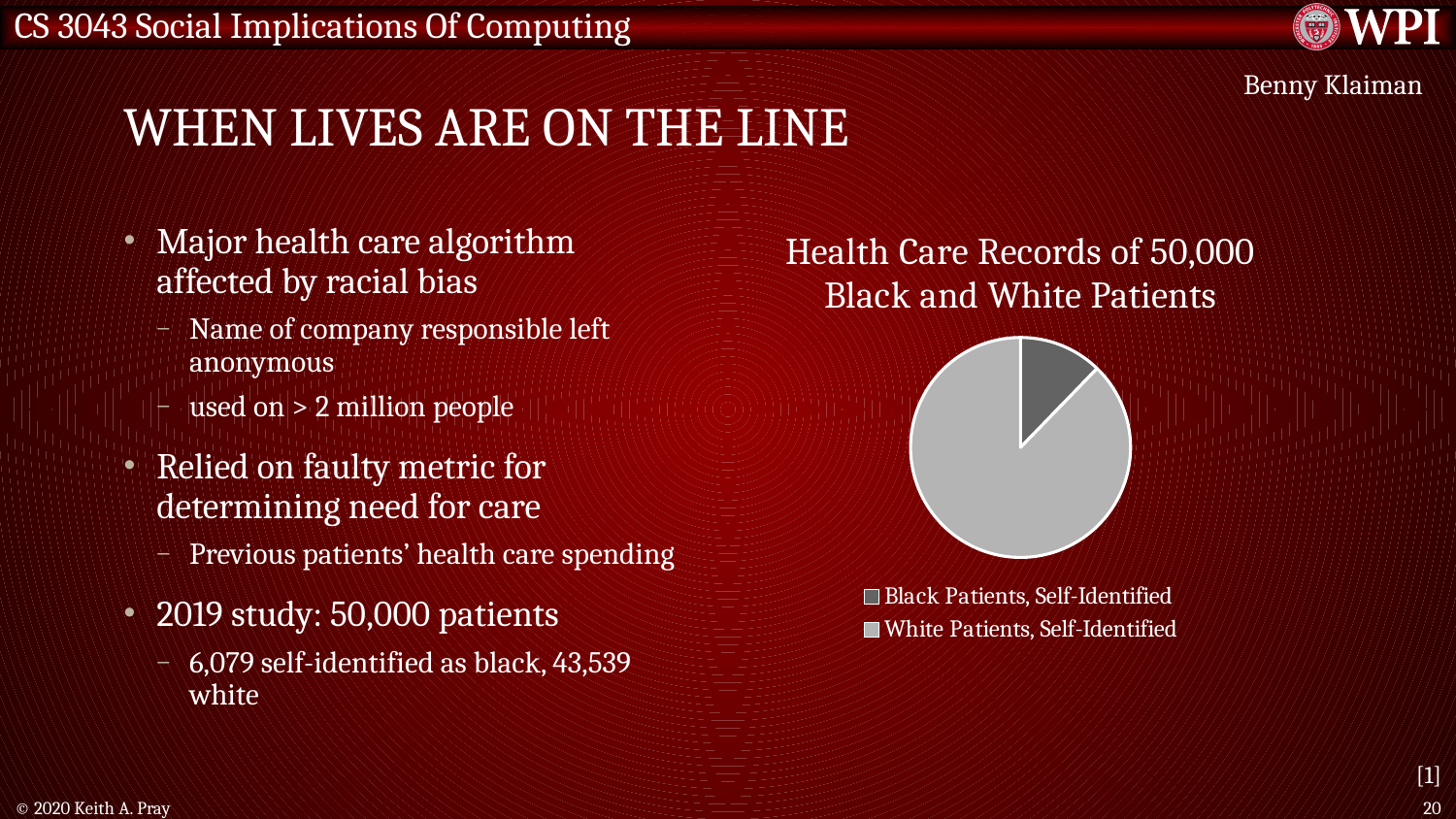
Which slice of the pie chart is the largest? White Patients, Self-Identified What is the title of the pie chart? Health Care Records of 50,000 Black and White Patients How many slices does the pie chart have? 2 What kind of chart is shown on the slide? pie chart In the pie chart, which slice is larger: Black Patients, Self-Identified or White Patients, Self-Identified? White Patients, Self-Identified Which slice of the pie chart is the smallest? Black Patients, Self-Identified Which legend entry in the pie chart is shown in the darker grey colour? Black Patients, Self-Identified How many entries does the pie chart's legend list? 2